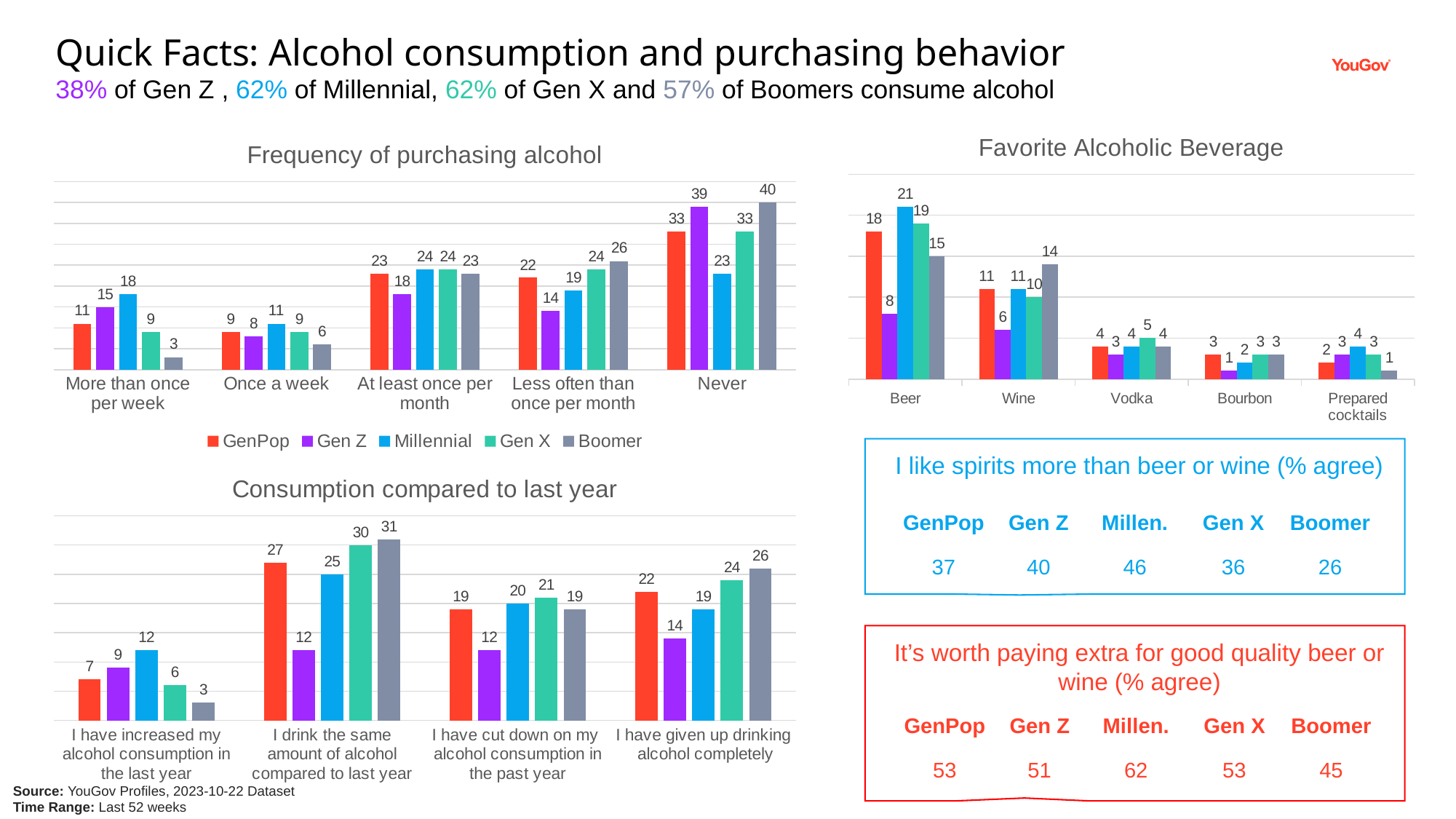
In the 'Frequency of purchasing alcohol' chart, which series has the lowest value in the 'More than once per week' category? Boomer In the 'Consumption compared to last year' chart, how many categories are shown on the x axis? 4 In the 'Consumption compared to last year' chart, what is the value for GenPop in 'I drink the same amount of alcohol compared to last year'? 27 In the 'Favorite Alcoholic Beverage' chart, which series has the highest value for Wine? Boomer In the 'Frequency of purchasing alcohol' chart, what is the value for Boomer in the 'Never' category? 40 In the 'Favorite Alcoholic Beverage' chart, what is the value for Millennial for Beer? 21 In the 'Favorite Alcoholic Beverage' chart, is the Gen Z value for Beer larger or smaller than the Gen X value for Beer? smaller In the 'Frequency of purchasing alcohol' chart, what is the difference between the Millennial and Boomer values for 'More than once per week'? 15 What kind of chart is the 'Favorite Alcoholic Beverage' chart? bar chart How many series does the legend of the 'Frequency of purchasing alcohol' chart list? 5 In the 'Frequency of purchasing alcohol' chart, what is the value for Gen Z in the 'Less often than once per month' category? 14 In the 'Consumption compared to last year' chart, which series has the highest value for 'I have given up drinking alcohol completely'? Boomer